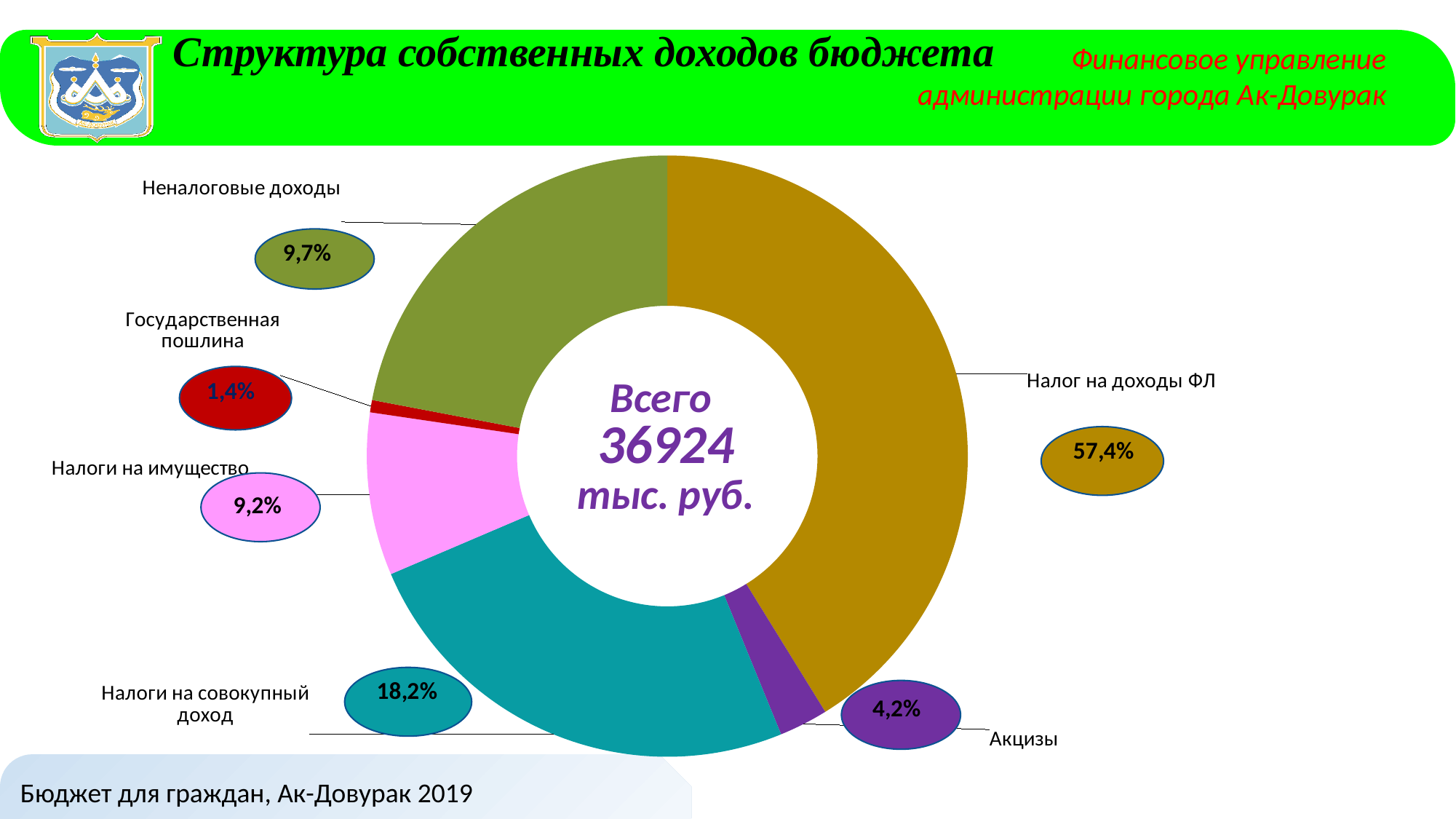
What is the difference in percentage points between Налог на доходы ФЛ and Налоги на совокупный доход? 39,2 What total amount is shown in the centre of the chart? 36924 тыс. руб. Which is larger: the share of Неналоговые доходы or the share of Налоги на имущество? Неналоговые доходы What percentage is shown for Акцизы? 4,2% Which category has the largest share of the budget's own revenues? Налог на доходы ФЛ What percentage is shown for Налоги на совокупный доход? 18,2% What type of chart is shown on the slide? Doughnut (pie) chart What is the difference in percentage points between Налоги на совокупный доход and Акцизы? 14 What share of the budget's own revenues does Налог на доходы ФЛ account for? 57,4% What percentage is shown for Государственная пошлина? 1,4% Which category has the smallest share of the budget's own revenues? Государственная пошлина How many categories are shown in the chart? 6